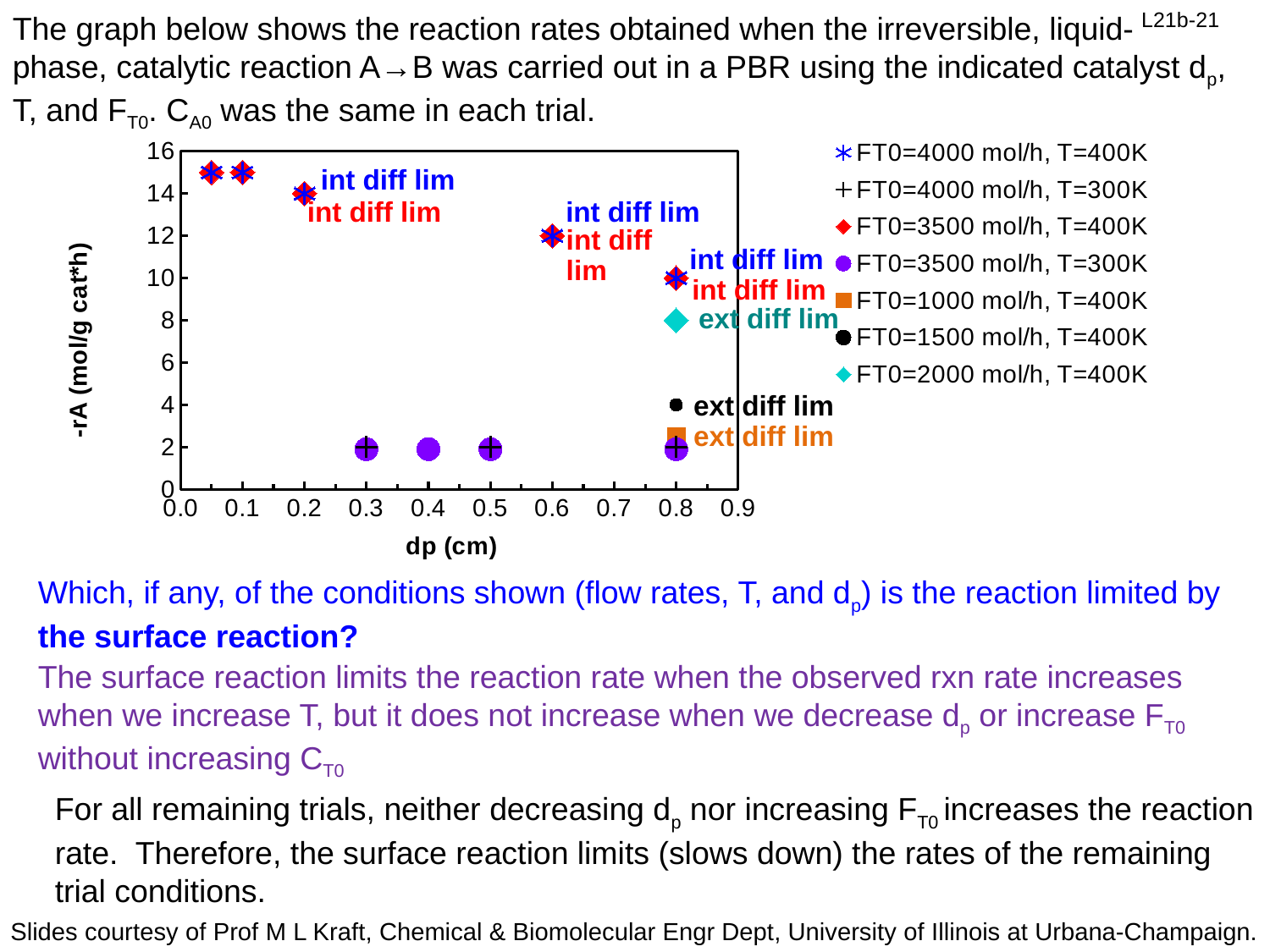
How many series does the legend list? 7 At dp = 0.8 cm, which has the larger -rA: FT0=2000 mol/h, T=400K or FT0=1500 mol/h, T=400K? FT0=2000 mol/h, T=400K What kind of chart is shown on the slide? scatter plot What is the value of -rA for FT0=4000 mol/h, T=400K at dp = 0.2 cm? 14 What is the y-axis label of the chart? -rA (mol/g cat*h) What is the value of -rA for FT0=4000 mol/h, T=400K at dp = 0.6 cm? 12 What is the x-axis label of the chart? dp (cm) For the FT0=4000 mol/h, T=400K series, does -rA rise or fall as dp increases? fall What is the value of -rA for FT0=1500 mol/h, T=400K at dp = 0.8 cm? 4 What is the value of -rA for FT0=2000 mol/h, T=400K at dp = 0.8 cm? 8 Is the value of -rA for FT0=1000 mol/h, T=400K at dp = 0.8 cm greater or less than 4? less